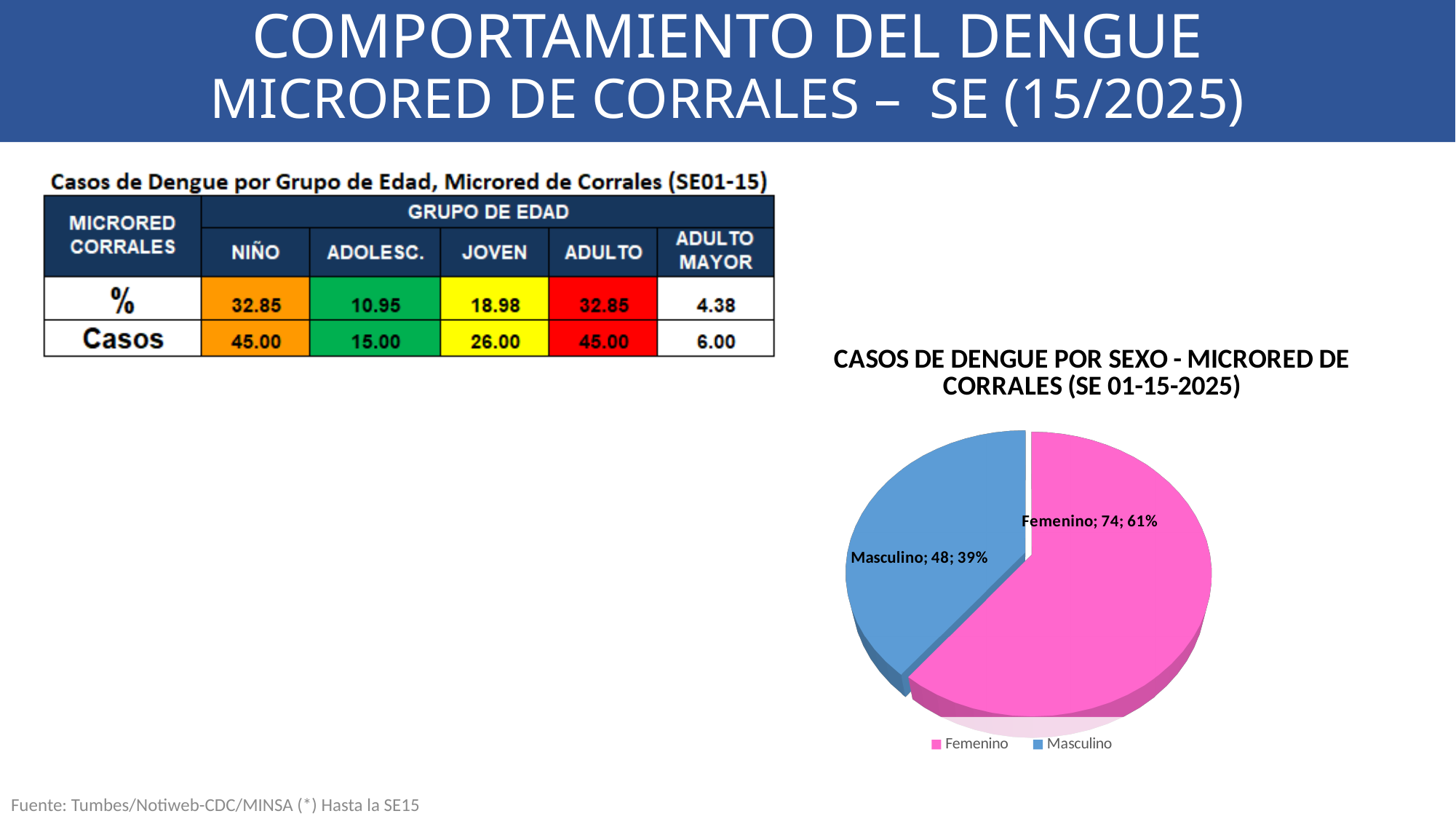
Which category has the smallest slice in the pie chart? Masculino Which has more cases in the pie chart, Femenino or Masculino? Femenino How many slices does the pie chart have? 2 What is the title of the pie chart? CASOS DE DENGUE POR SEXO - MICRORED DE CORRALES (SE 01-15-2025) What share of the pie chart does the Femenino slice take? 61% What share of the pie chart does the Masculino slice take? 39% How many cases does the Femenino slice of the pie chart represent? 74 Which category has the largest slice in the pie chart? Femenino How many cases does the Masculino slice of the pie chart represent? 48 What is the difference in cases between Femenino and Masculino in the pie chart? 26 What is the total number of cases represented in the pie chart? 122 What kind of chart is shown on the slide? pie chart